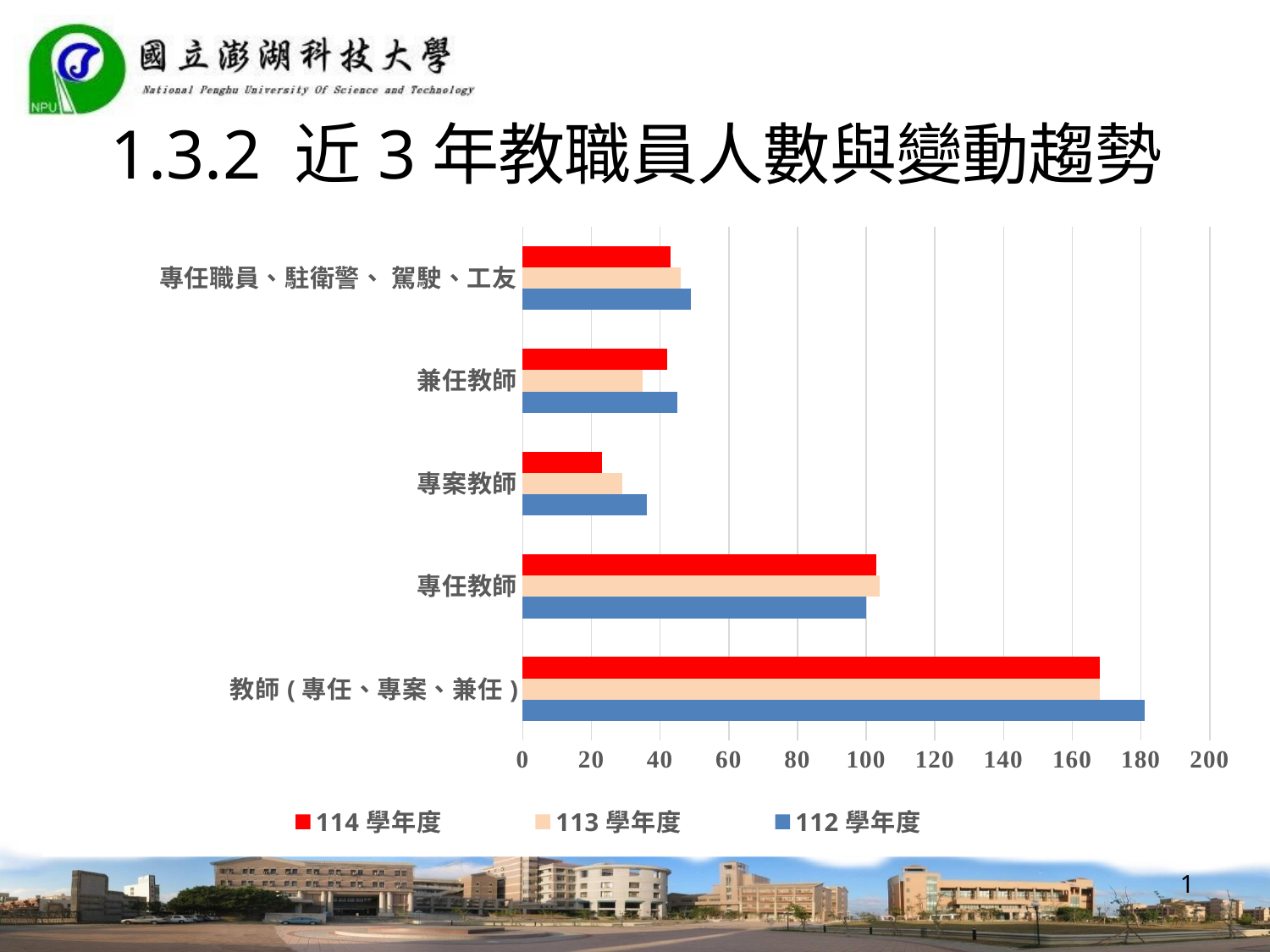
Is the value for 專案教師 in 114 學年度 greater or less than 40? less Which colour represents 114 學年度 in the legend? red Is the value for 教師(專任、專案、兼任) in 112 學年度 greater or less than 160? greater Which colour represents 112 學年度 in the legend? blue What kind of chart is shown on the slide? bar chart How many series does the legend list? 3 How many categories are shown on the chart? 5 For 專案教師, which is larger: the value for 112 學年度 or 114 學年度? 112 學年度 Is the value for 專任職員、駐衛警、駕駛、工友 in 112 學年度 greater or less than 60? less Which category has the shortest bar for 114 學年度? 專案教師 For 兼任教師, which is larger: the value for 113 學年度 or 112 學年度? 112 學年度 Which category has the longest bar for 112 學年度? 教師(專任、專案、兼任)